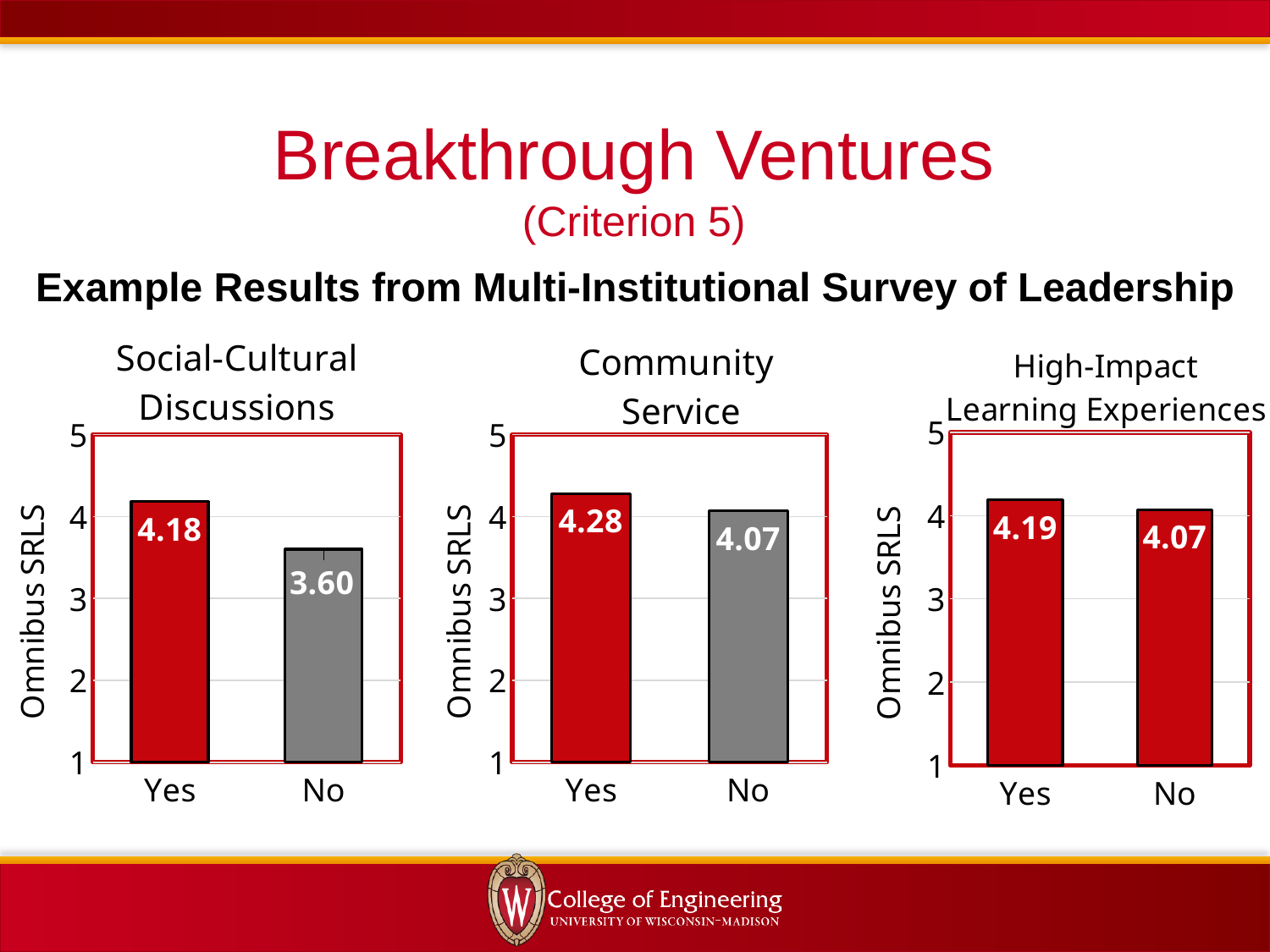
In the High-Impact Learning Experiences chart, what is the value for No? 4.07 In the Community Service chart, which category has the lowest value? No In the Social-Cultural Discussions chart, is the value for No greater or less than 4? less In the Social-Cultural Discussions chart, what is the difference between the Yes and No values? 0.58 In the Community Service chart, what is the difference between the Yes and No values? 0.21 In the Social-Cultural Discussions chart, what is the Omnibus SRLS value for No? 3.60 In the Social-Cultural Discussions chart, what is the Omnibus SRLS value for Yes? 4.18 How many categories are shown in the Community Service chart? 2 In the High-Impact Learning Experiences chart, which category has the higher value, Yes or No? Yes In the Community Service chart, what is the value for Yes? 4.28 What kind of chart is the High-Impact Learning Experiences chart? Bar chart What is the y-axis label on the Social-Cultural Discussions chart? Omnibus SRLS